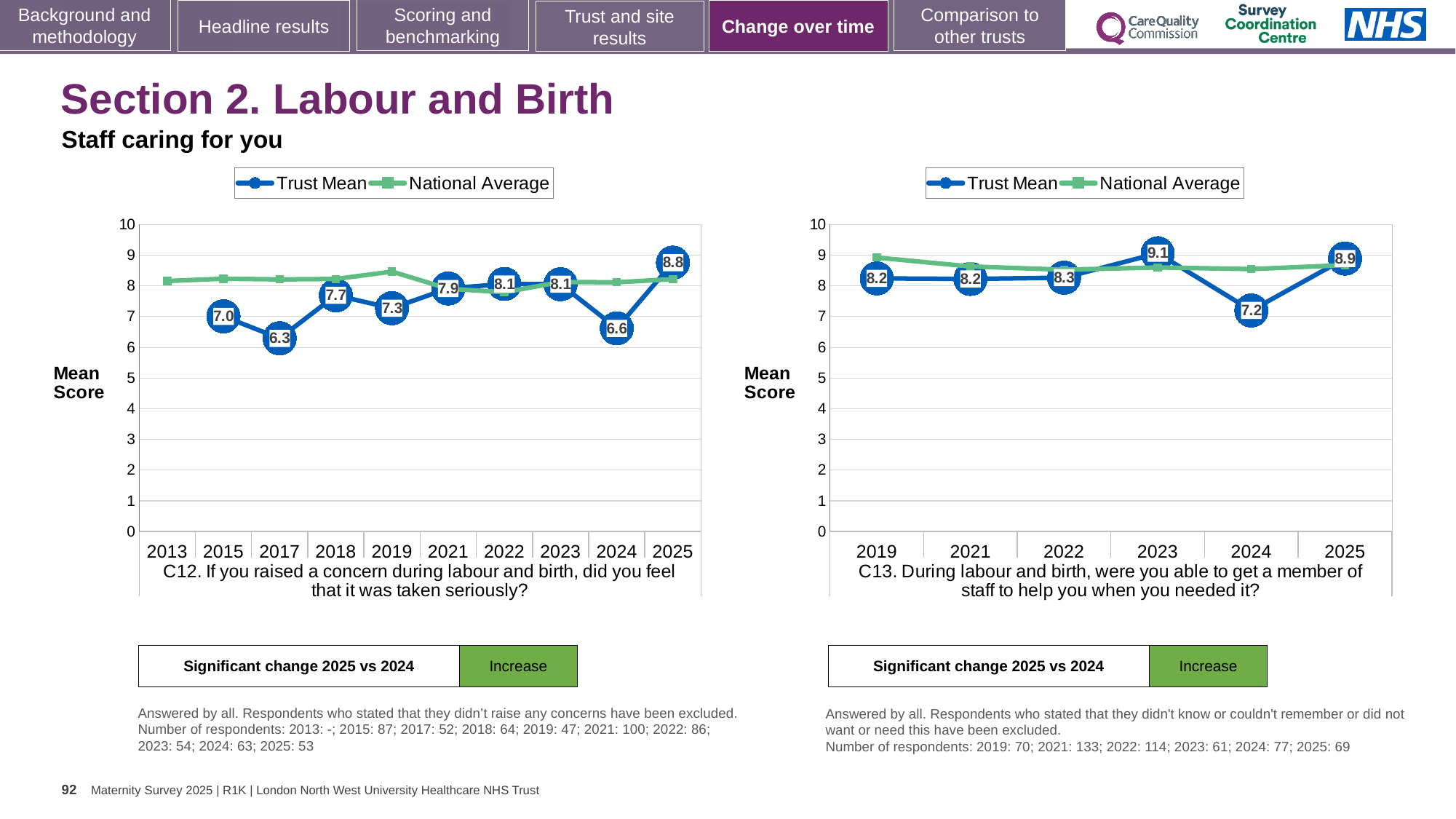
In the C12 chart, is the National Average for 2013 greater or less than 7? greater In the C13 chart, what is the Trust Mean for 2023? 9.1 In the C12 chart, which year has the lowest Trust Mean? 2017 In the C13 chart, which year has the highest Trust Mean? 2023 In the C12 chart, what is the difference between the Trust Mean for 2025 and 2024? 2.2 In the C13 chart, which year has the lowest Trust Mean? 2024 What type of chart is the C13 chart? Line chart In the C12 chart, what is the Trust Mean for 2017? 6.3 In the C12 chart, what is the Trust Mean for 2025? 8.8 In the C13 chart, how many series does the legend list? 2 In the C12 chart, how many years are shown on the x axis? 10 In the C13 chart, is the Trust Mean for 2024 larger or smaller than the Trust Mean for 2025? smaller